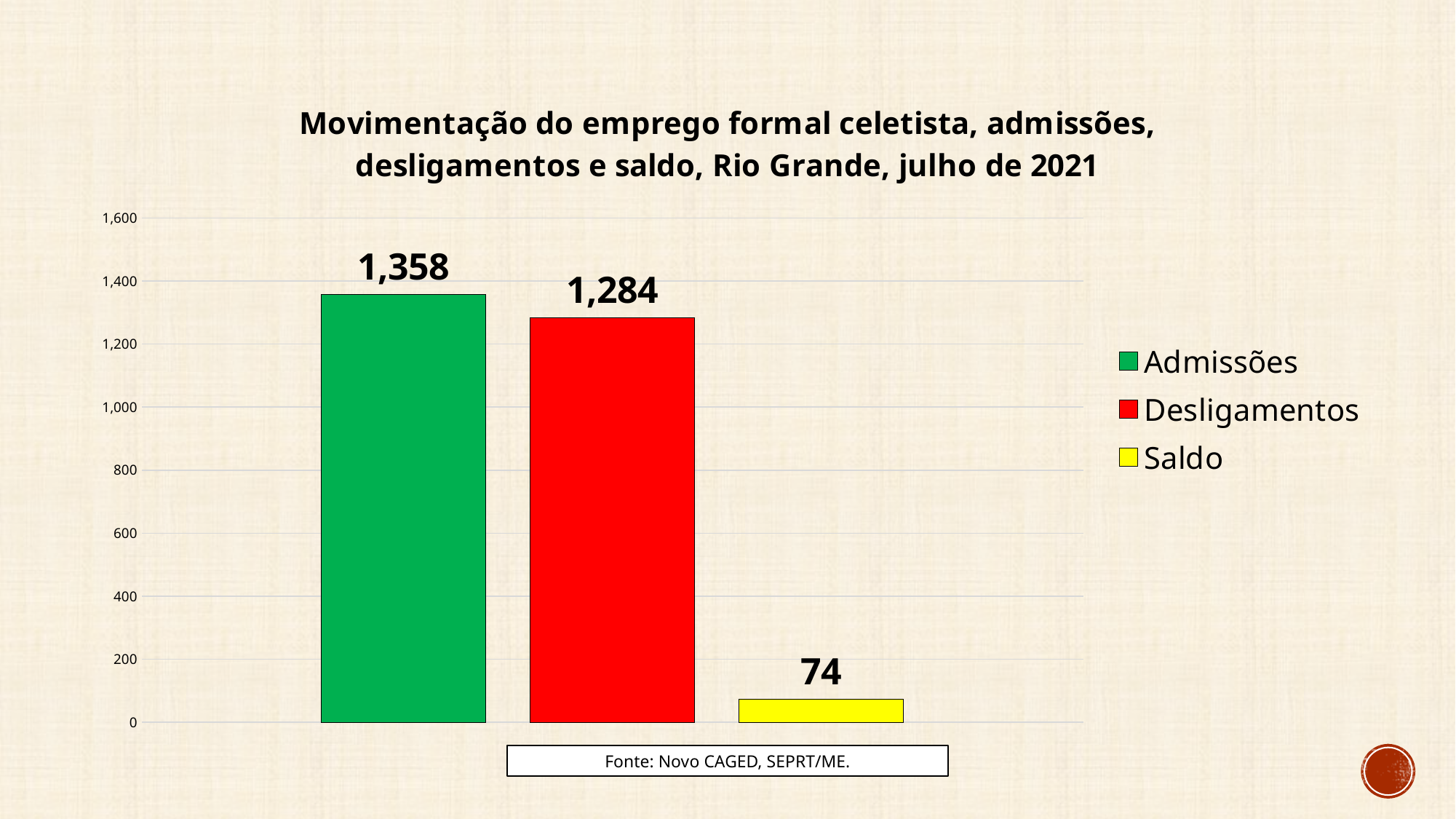
What is the value for Desligamentos? 1,284 Which is larger, Admissões or Desligamentos? Admissões Is the value for Desligamentos greater or less than 1,200? greater What is the difference between Admissões and Desligamentos? 74 Which series has the lowest value? Saldo What is the value for Saldo? 74 Which series has the highest value? Admissões What kind of chart is shown on the slide? Bar chart What is the value for Admissões? 1,358 How many series does the legend list? 3 What colour is the bar for Saldo? Yellow How many bars are plotted in the chart? 3